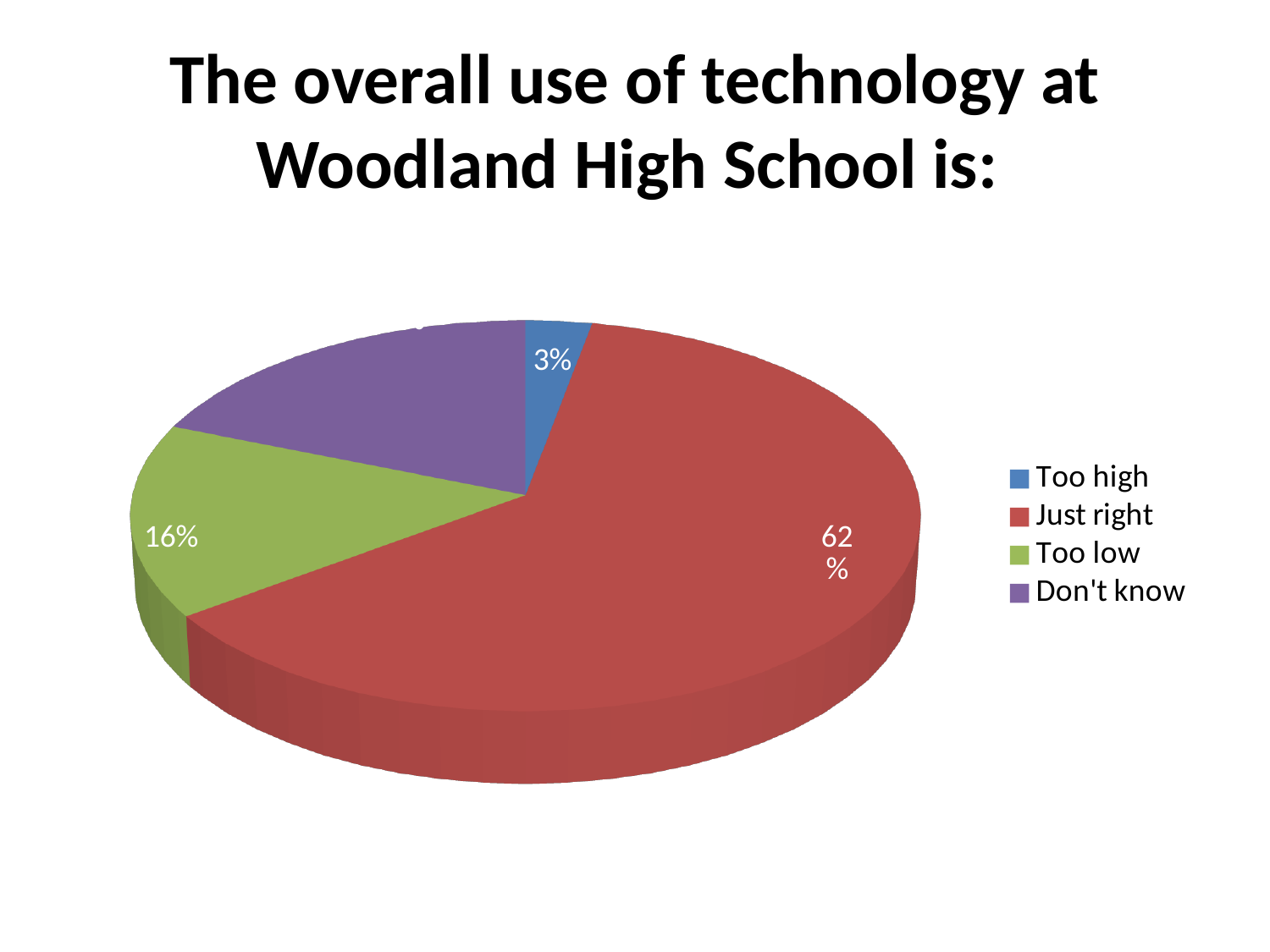
What percentage of the pie is the "Just right" slice? 62% Which slice is larger, "Too low" or "Too high"? Too low Which slice is larger, "Don't know" or "Too high"? Don't know Which slice is larger, "Just right" or "Don't know"? Just right Which category has the largest slice of the pie? Just right What colour is the "Just right" slice in the pie chart? red What kind of chart is shown on the slide? pie chart What is the difference in percentage points between the "Just right" and "Too low" slices? 46 How many categories does the pie chart show? 4 Which category has the smallest slice of the pie? Too high What percentage of the pie is the "Too low" slice? 16% What percentage of the pie is the "Too high" slice? 3%